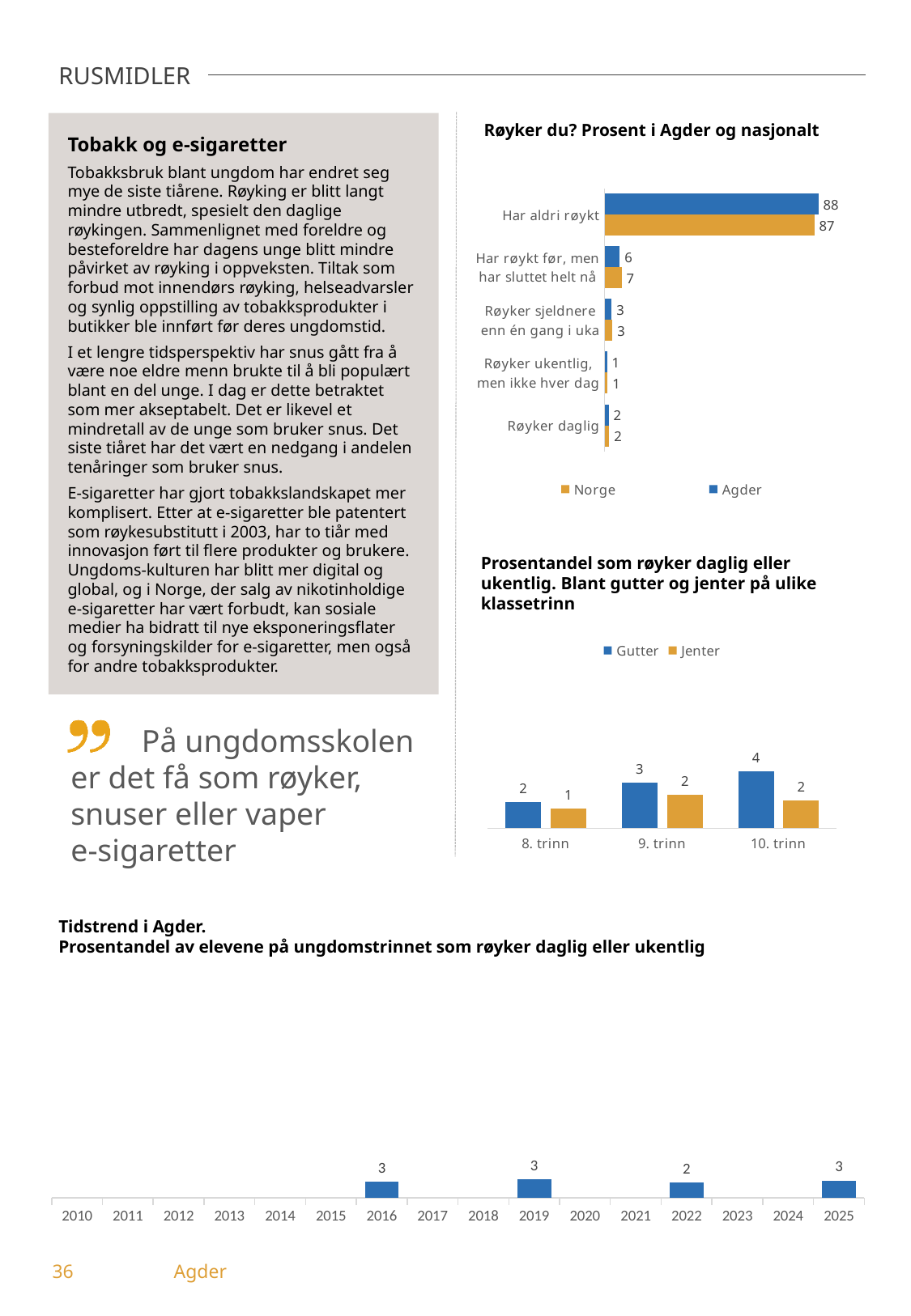
In the chart 'Prosentandel som røyker daglig eller ukentlig', what is the value for Gutter at 10. trinn? 4 What kind of chart is 'Tidstrend i Agder'? bar chart In the chart 'Røyker du? Prosent i Agder og nasjonalt', what is the value for Agder for 'Har aldri røykt'? 88 In the chart 'Røyker du? Prosent i Agder og nasjonalt', what is the difference between the Agder and Norge values for 'Har aldri røykt'? 1 In the chart 'Prosentandel som røyker daglig eller ukentlig', what is the value for Jenter at 8. trinn? 1 In the chart 'Røyker du? Prosent i Agder og nasjonalt', what is the value for Norge for 'Har røykt før, men har sluttet helt nå'? 7 In the chart 'Røyker du? Prosent i Agder og nasjonalt', how many categories are shown? 5 In the chart 'Røyker du? Prosent i Agder og nasjonalt', how many series does the legend list? 2 In the chart 'Tidstrend i Agder', what is the value for 2022? 2 In the chart 'Prosentandel som røyker daglig eller ukentlig', which is larger at 9. trinn, Gutter or Jenter? Gutter In the chart 'Røyker du? Prosent i Agder og nasjonalt', which category has the highest value for Agder? Har aldri røykt In the chart 'Prosentandel som røyker daglig eller ukentlig', do the Gutter values rise or fall from 8. trinn to 10. trinn? rise